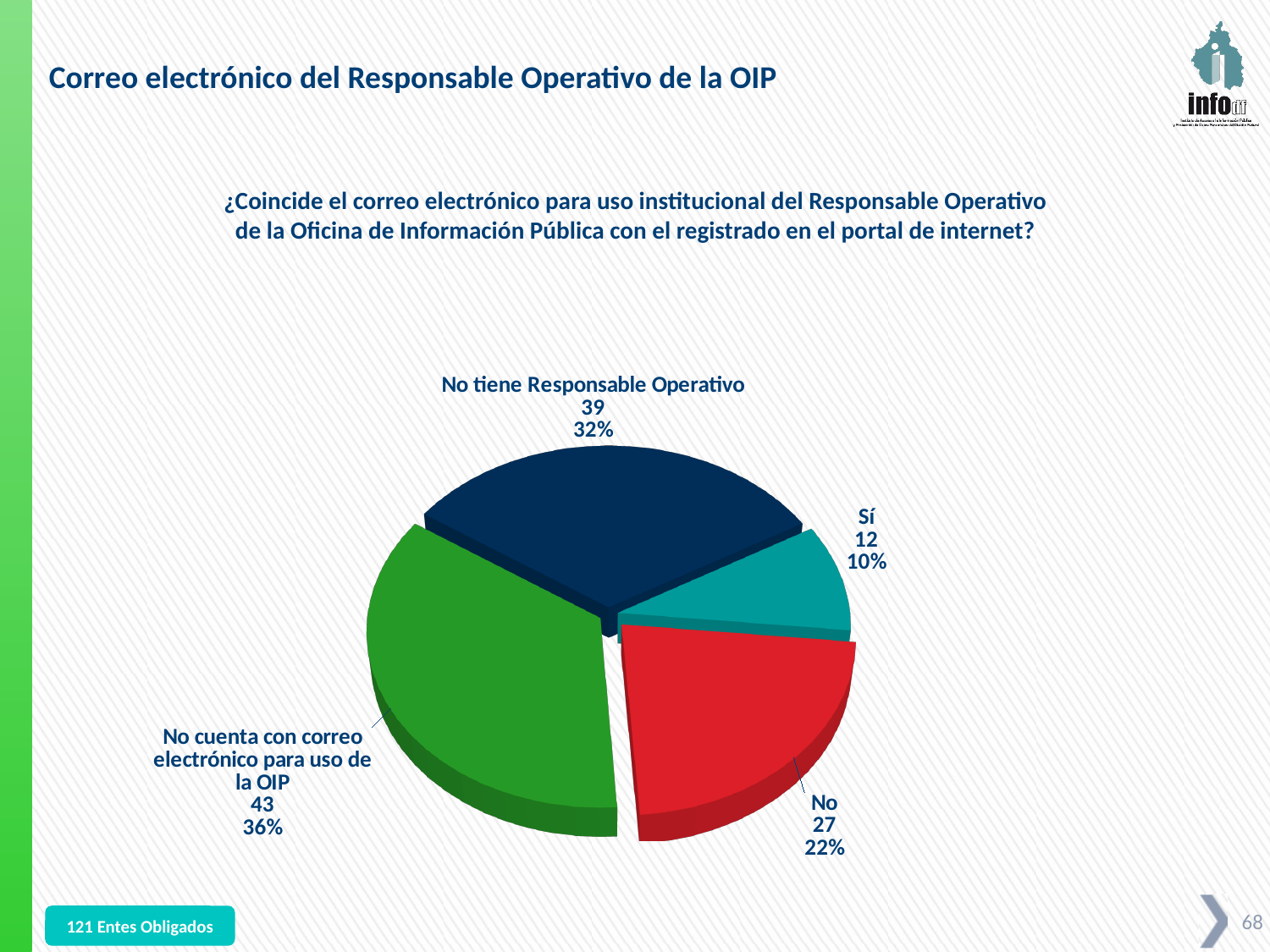
Which is larger, the count for 'No tiene Responsable Operativo' or the count for 'No'? No tiene Responsable Operativo What kind of chart is shown on the slide? pie chart What is the difference in count between 'No' and 'Sí'? 15 Which category has the smallest slice? Sí Which category has the largest slice? No cuenta con correo electrónico para uso de la OIP What is the count for the 'Sí' slice? 12 What is the count for 'No tiene Responsable Operativo'? 39 What percentage does the 'No' slice represent? 22% What is the total count across all four slices? 121 What colour is the 'Sí' slice? teal How many slices does the pie chart have? 4 What percentage does 'No cuenta con correo electrónico para uso de la OIP' represent? 36%